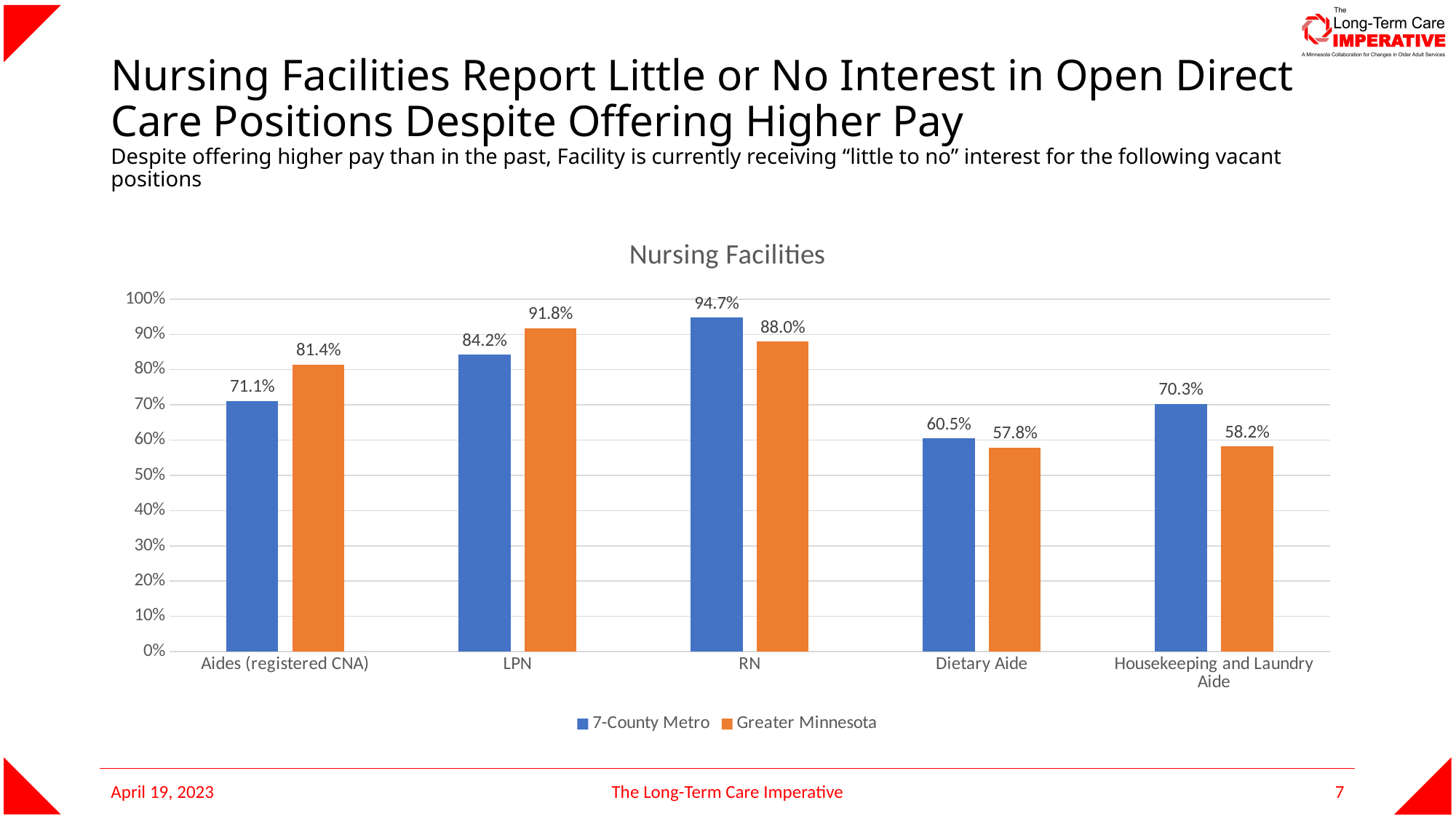
What is the title of the chart? Nursing Facilities Which category has the highest 7-County Metro value? RN What is the Greater Minnesota value for LPN? 91.8% What kind of chart is shown on the slide? bar chart Which is larger for Dietary Aide, the 7-County Metro value or the Greater Minnesota value? 7-County Metro Is the 7-County Metro value for LPN greater or less than 80%? greater How many position categories are shown on the x axis? 5 What is the 7-County Metro value for RN? 94.7% How many series does the legend list? 2 What is the difference between the Greater Minnesota and 7-County Metro values for Aides (registered CNA)? 10.3% What is the Greater Minnesota value for Housekeeping and Laundry Aide? 58.2% Which category has the lowest Greater Minnesota value? Dietary Aide